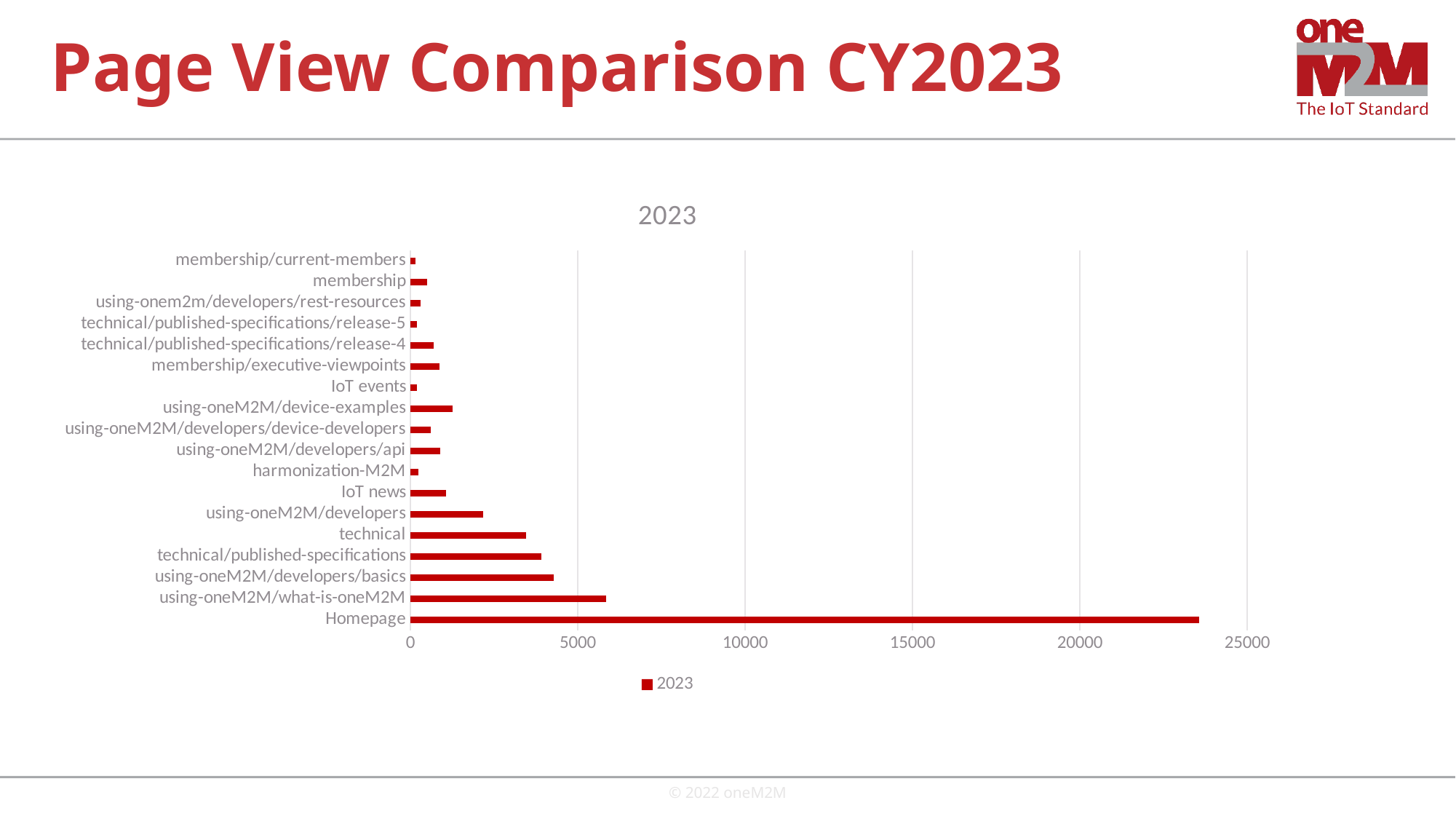
Which has more page views, technical or using-oneM2M/developers? technical Is the value for Homepage greater or less than 20000? greater Which has more page views, using-oneM2M/device-examples or IoT events? using-oneM2M/device-examples How many pages (categories) are listed in the chart? 18 What is the title shown above the chart? 2023 Is the value for using-oneM2M/what-is-oneM2M greater or less than 5000? greater What kind of chart is shown on the slide? bar chart How many series does the legend list? 1 Which page has the highest number of page views in the chart? Homepage Is the value for technical greater or less than 5000? less Which has more page views, Homepage or using-oneM2M/what-is-oneM2M? Homepage